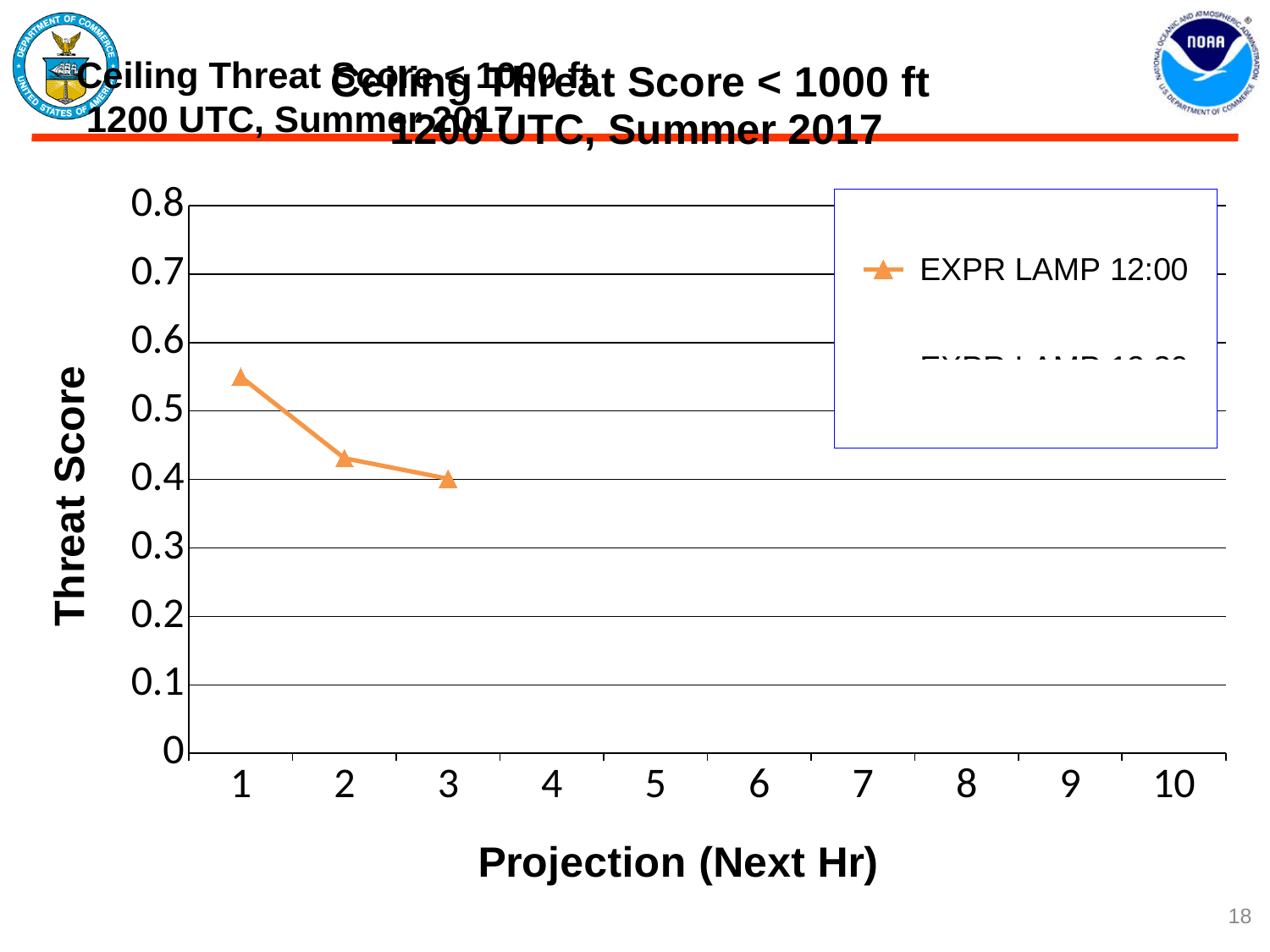
Which projection has the larger EXPR LAMP 12:00 threat score, 1 or 3? 1 What kind of chart is shown on the slide? line chart Does the threat score for EXPR LAMP 12:00 rise or fall as the projection increases from 1 to 3? fall Is the threat score for EXPR LAMP 12:00 at projection 1 greater or less than 0.6? less What is the title of the x axis? Projection (Next Hr) Is the threat score for EXPR LAMP 12:00 at projection 1 greater or less than 0.5? greater Is the threat score for EXPR LAMP 12:00 at projection 2 greater or less than 0.4? greater At which projection is the EXPR LAMP 12:00 threat score highest? 1 How many data points are plotted for the EXPR LAMP 12:00 series? 3 What is the title of the y axis? Threat Score How many projection values are labelled on the x axis? 10